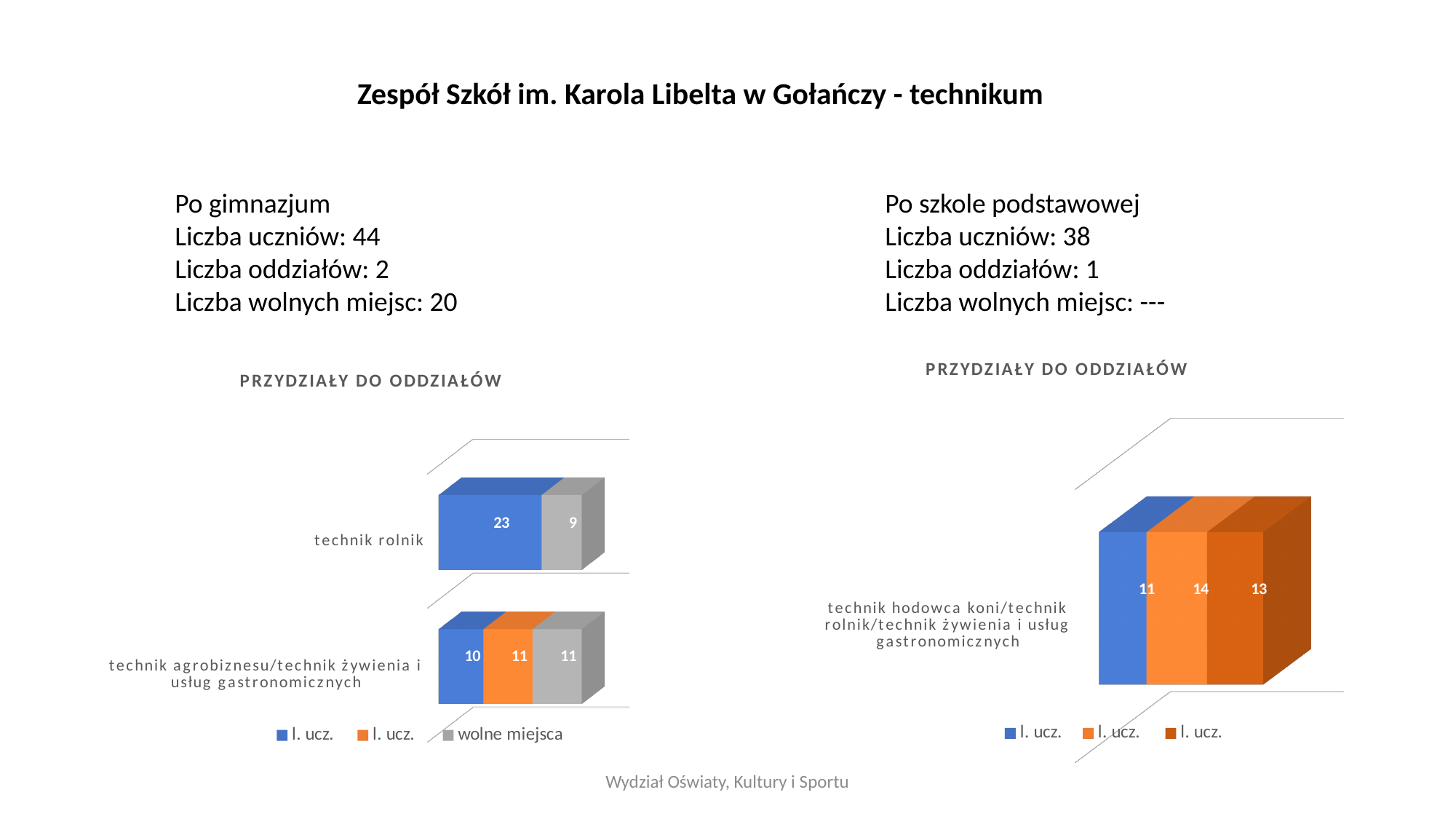
In the right chart, how many categories are shown? 1 In the left chart, what is the value of 'wolne miejsca' for 'technik rolnik'? 9 In the left chart, what is the total of the stacked bar for 'technik rolnik'? 32 In the left chart, what is the total of the stacked bar for 'technik agrobiznesu/technik żywienia i usług gastronomicznych'? 32 In the left chart, how many categories are shown? 2 In the left chart, how many series does the legend list? 3 What kind of chart is the left chart? bar chart In the right chart, what is the total of the stacked bar? 38 In the left chart, what is the difference between the 'wolne miejsca' values for 'technik agrobiznesu/technik żywienia i usług gastronomicznych' and 'technik rolnik'? 2 In the right chart, what is the largest segment value in the stacked bar? 14 In the left chart, what is the value of the blue segment for 'technik rolnik'? 23 In the right chart, what is the difference between the orange segment (14) and the blue segment (11)? 3